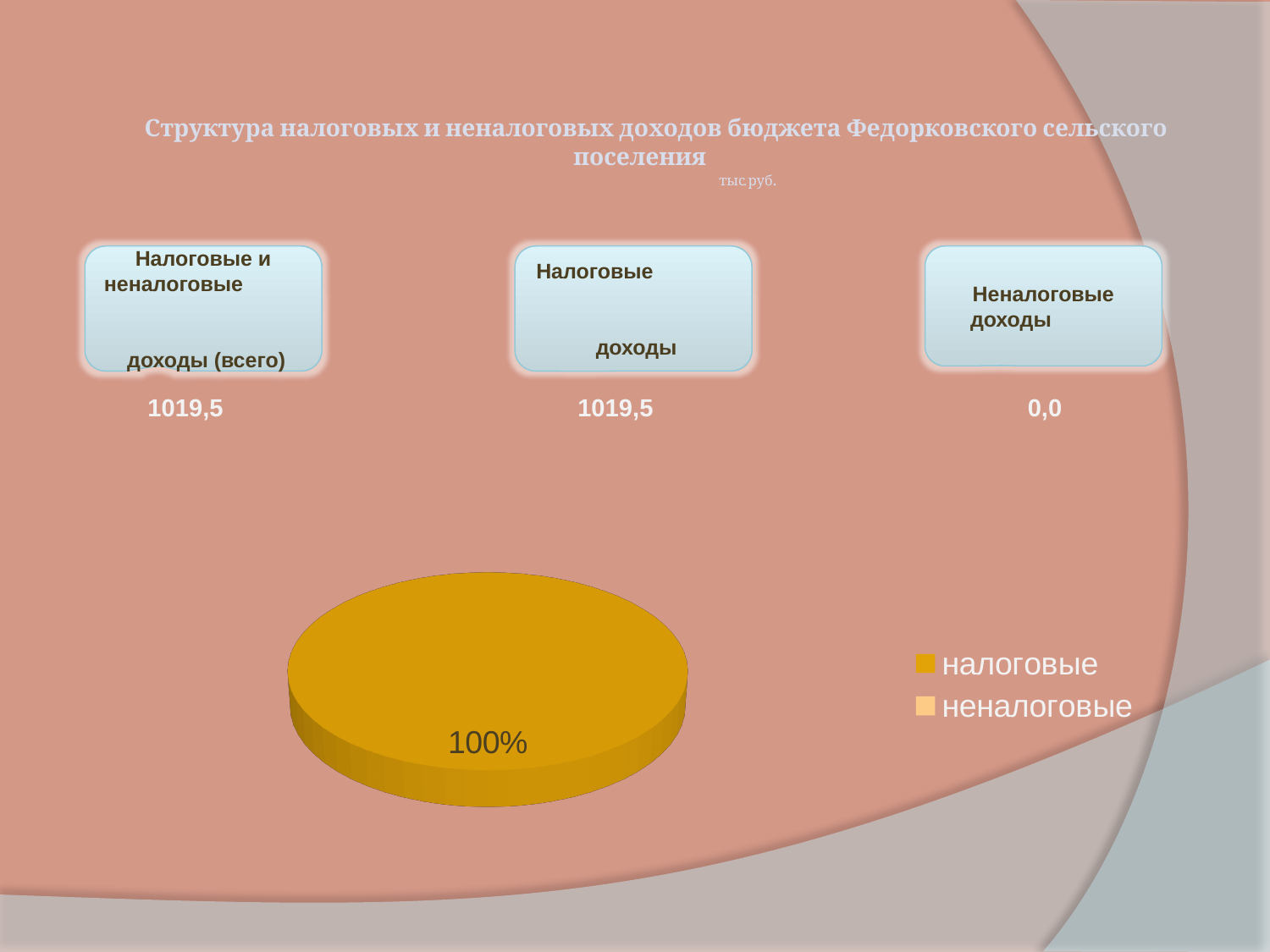
Which category has the larger share of the pie, налоговые or неналоговые? налоговые Which category has the smallest share of the pie? неналоговые What share of the pie does the налоговые slice take? 100% What colour is the налоговые slice in the pie chart? gold (dark yellow) What kind of chart is shown on the slide? pie chart How many entries does the pie chart's legend list? 2 What percentage label is printed on the pie chart? 100% Is the share of the налоговые slice greater or less than 50%? greater What are the two legend entries of the pie chart? налоговые, неналоговые Which category has the largest share of the pie? налоговые